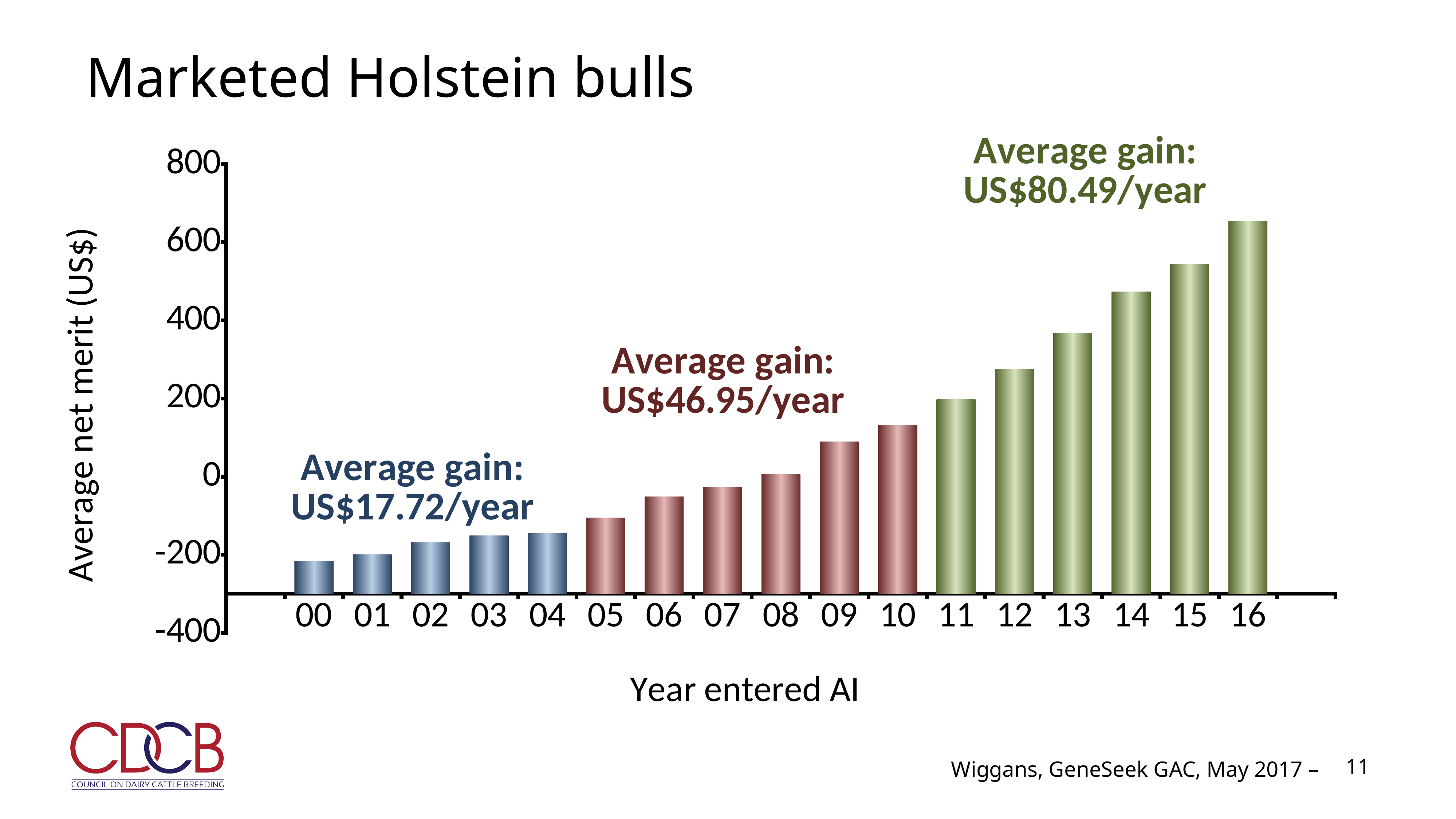
Is the average net merit for year 13 greater or less than 400? less Do the average net merit values rise or fall as the year entered AI increases? rise How many years (bars) are plotted on the chart? 17 What kind of chart is shown on the slide? bar chart Which has a higher average net merit, year 14 or year 10? 14 What average gain per year is stated for the green group of bars (years 11 to 16)? US$80.49/year What is the label of the x axis? Year entered AI Which year entered AI has the lowest average net merit? 00 Is the average net merit for year 05 greater or less than 0? less Is the average net merit for year 16 greater or less than 600? greater Which year entered AI has the highest average net merit? 16